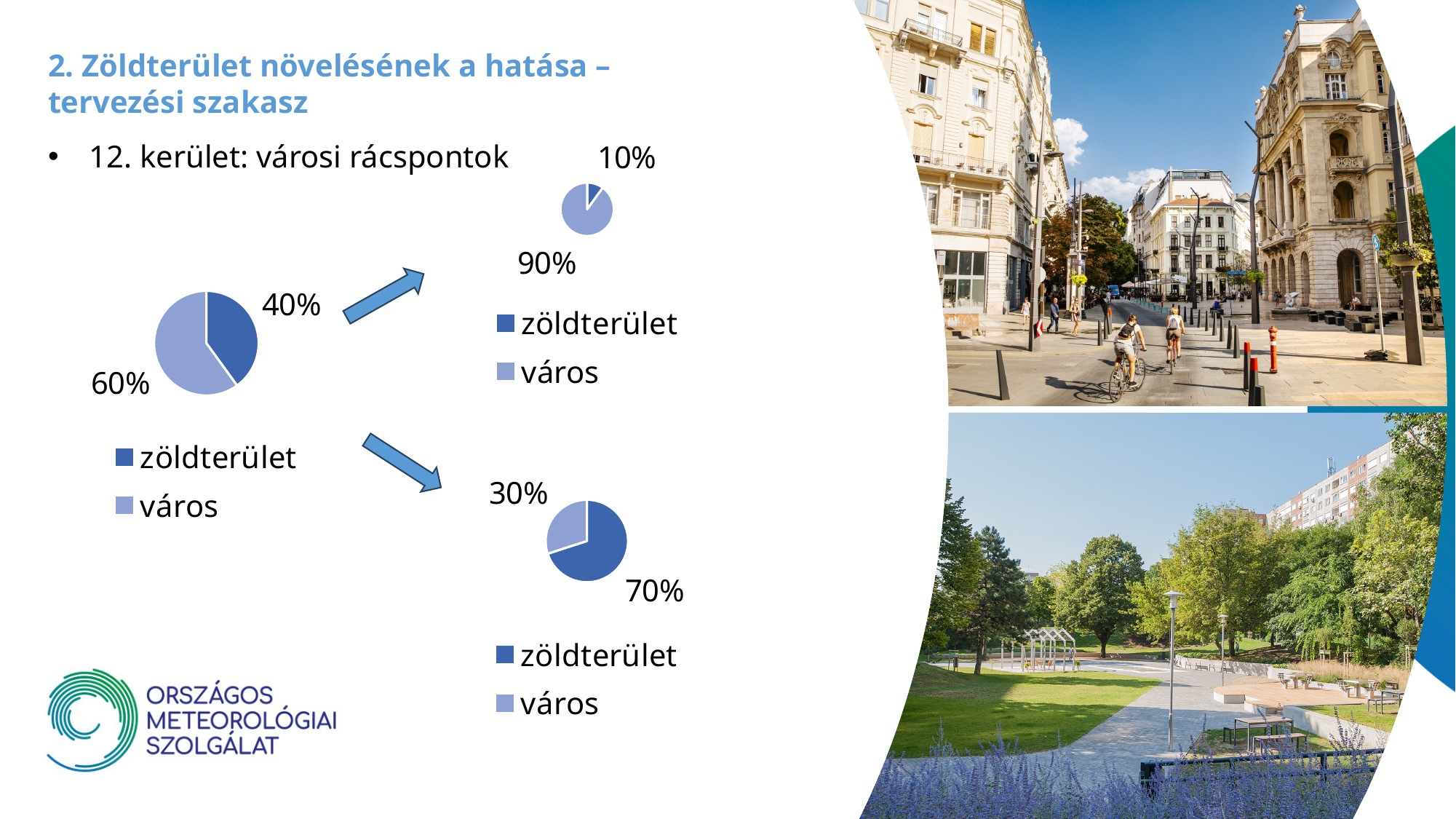
In the pie chart at the top right of the slide, what share is labelled for zöldterület? 10% In the pie chart on the left of the slide, which category has the larger slice? város In the pie chart at the top right of the slide, what is the difference between the város share and the zöldterület share? 80% How many categories does the legend of the pie chart on the left of the slide list? 2 What type of chart is used for the three charts on the slide? Pie chart In the pie chart at the bottom right of the slide, what share is labelled for város? 30% In the pie chart at the bottom right of the slide, which category has the smaller slice? város In the pie chart on the left of the slide, what share is labelled for zöldterület? 40% How many pie charts are shown on the slide? 3 In the pie chart on the left of the slide, what share is labelled for város? 60% In the pie chart at the top right of the slide, what share is labelled for város? 90% In the pie chart at the bottom right of the slide, what share is labelled for zöldterület? 70%